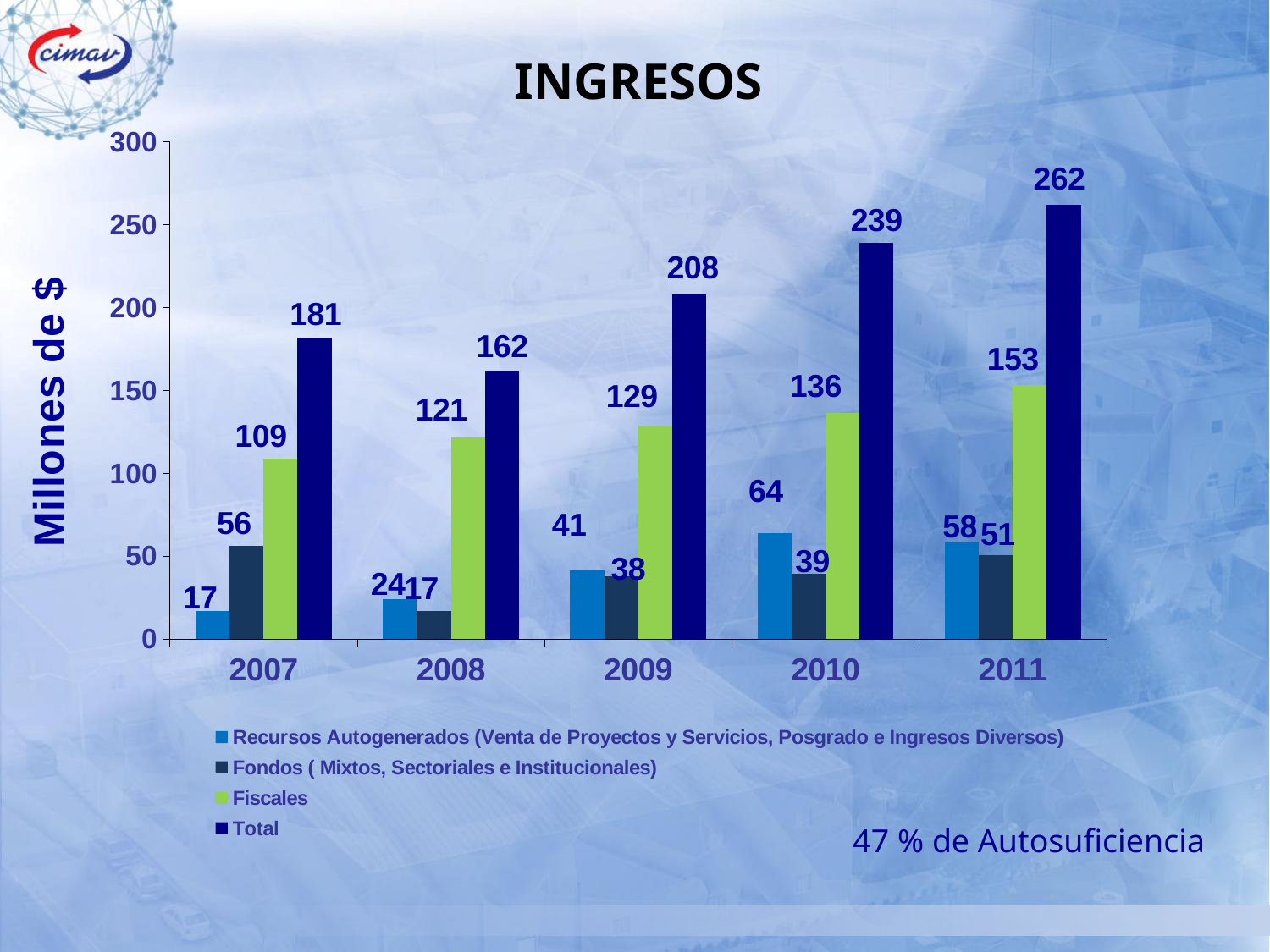
What kind of chart is shown? Bar chart Which is larger in 2008: Recursos Autogenerados or Fondos? Recursos Autogenerados How many years are shown on the x axis? 5 What is the Total value for 2011? 262 What is the Fiscales value for 2009? 129 What is the Recursos Autogenerados value for 2010? 64 Which year has the lowest Recursos Autogenerados value? 2007 Does the Total rise or fall from 2007 to 2011? Rise How many series does the legend list? 4 What is the Fondos value for 2007? 56 What is the difference between the Total for 2011 and the Total for 2007? 81 Which year has the highest Total? 2011